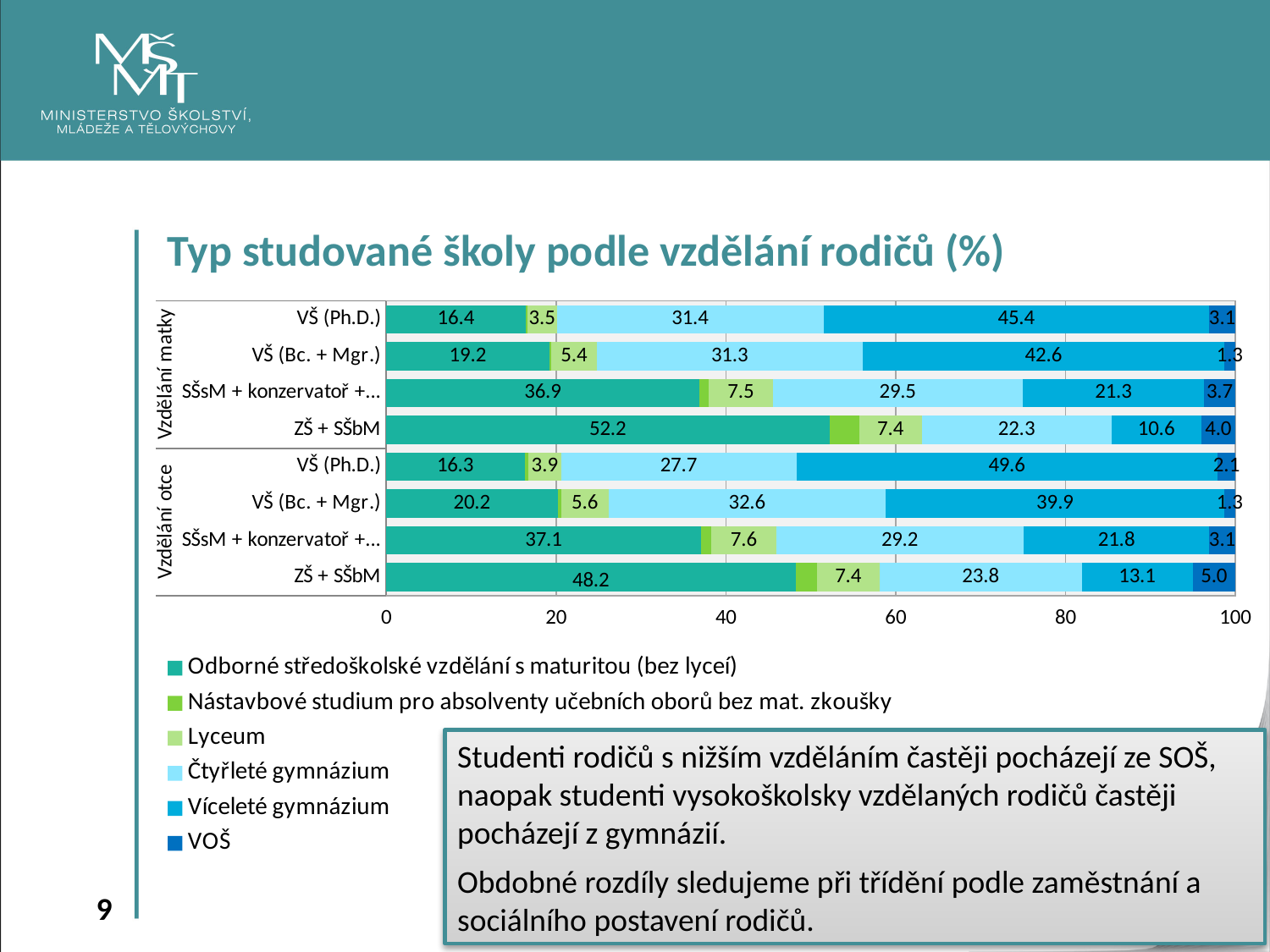
What is the title of the chart? Typ studované školy podle vzdělání rodičů (%) What is the value of Odborné středoškolské vzdělání s maturitou (bez lyceí) for ZŠ + SŠbM under Vzdělání otce? 48.2 Which category has the lowest value for Víceleté gymnázium? ZŠ + SŠbM (Vzdělání matky) What is the value of Čtyřleté gymnázium for VŠ (Bc. + Mgr.) under Vzdělání otce? 32.6 What is the value of Víceleté gymnázium for VŠ (Ph.D.) under Vzdělání matky? 45.4 What type of chart is shown on the slide? Stacked bar chart What is the VOŠ value for ZŠ + SŠbM under Vzdělání otce? 5.0 How many series does the legend list? 6 Which is larger for Čtyřleté gymnázium: VŠ (Ph.D.) under Vzdělání matky or VŠ (Ph.D.) under Vzdělání otce? VŠ (Ph.D.) under Vzdělání matky How many category bars are shown in the chart? 8 What is the difference in Víceleté gymnázium between VŠ (Ph.D.) under Vzdělání otce and VŠ (Ph.D.) under Vzdělání matky? 4.2 Which category has the highest value for Odborné středoškolské vzdělání s maturitou (bez lyceí)? ZŠ + SŠbM (Vzdělání matky)